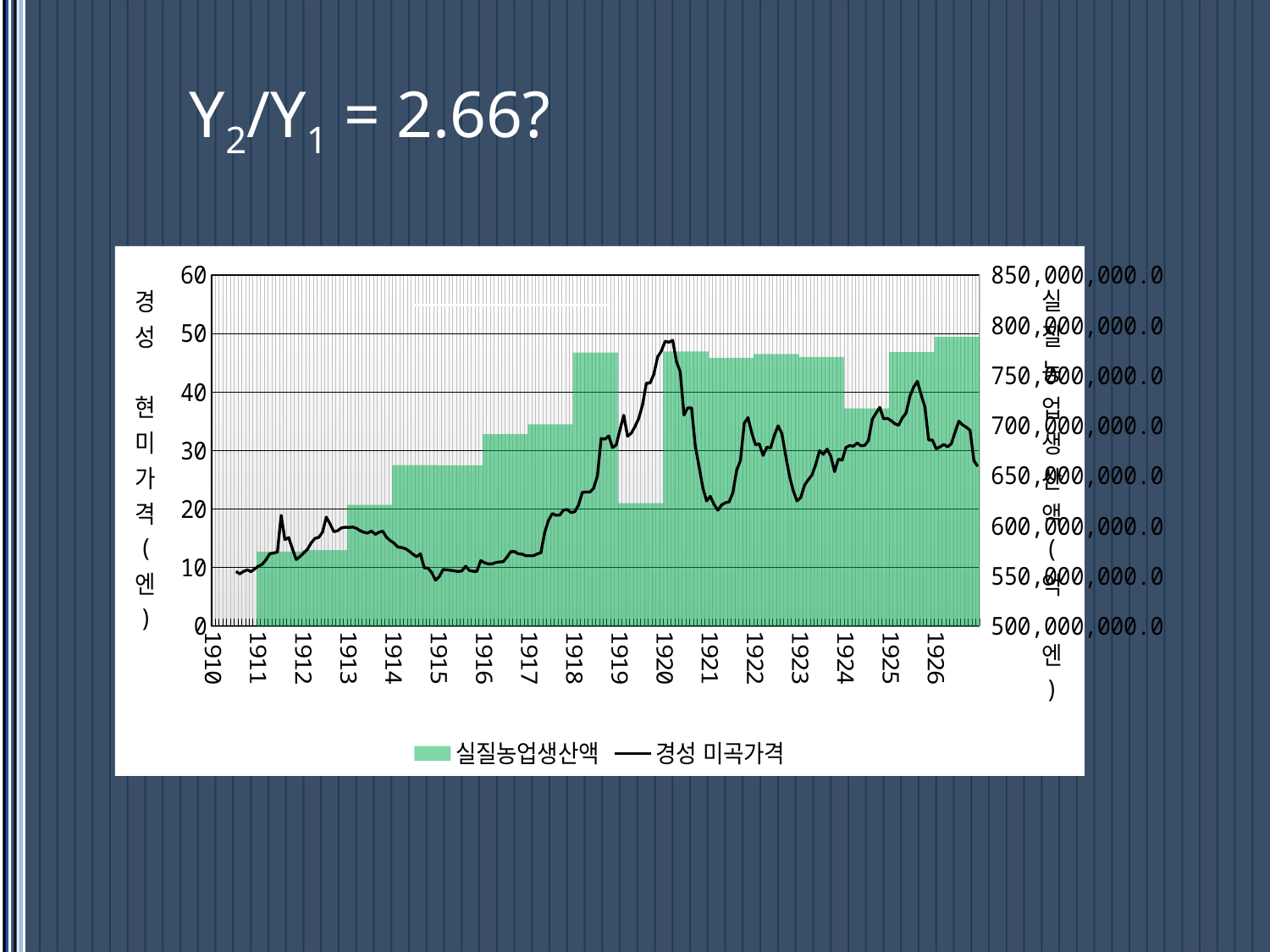
How many series does the chart legend list? 2 Which series is drawn as a black line in the chart? 경성 미곡가격 Is the peak value of the 경성 미곡가격 line around 1920 greater or less than 40 on the left axis? greater What kind of chart is shown on the slide? A combination bar and line chart Is the 실질농업생산액 bar for 1919 greater or less than 650,000,000.0 on the right axis? less Which year has the larger 실질농업생산액 bar, 1918 or 1919? 1918 In which year does the 경성 미곡가격 line reach its highest point? 1920 Which series is drawn as green bars in the chart? 실질농업생산액 How many year labels are shown on the x axis of the chart? 17 Which year has the highest green bar for 실질농업생산액? 1926